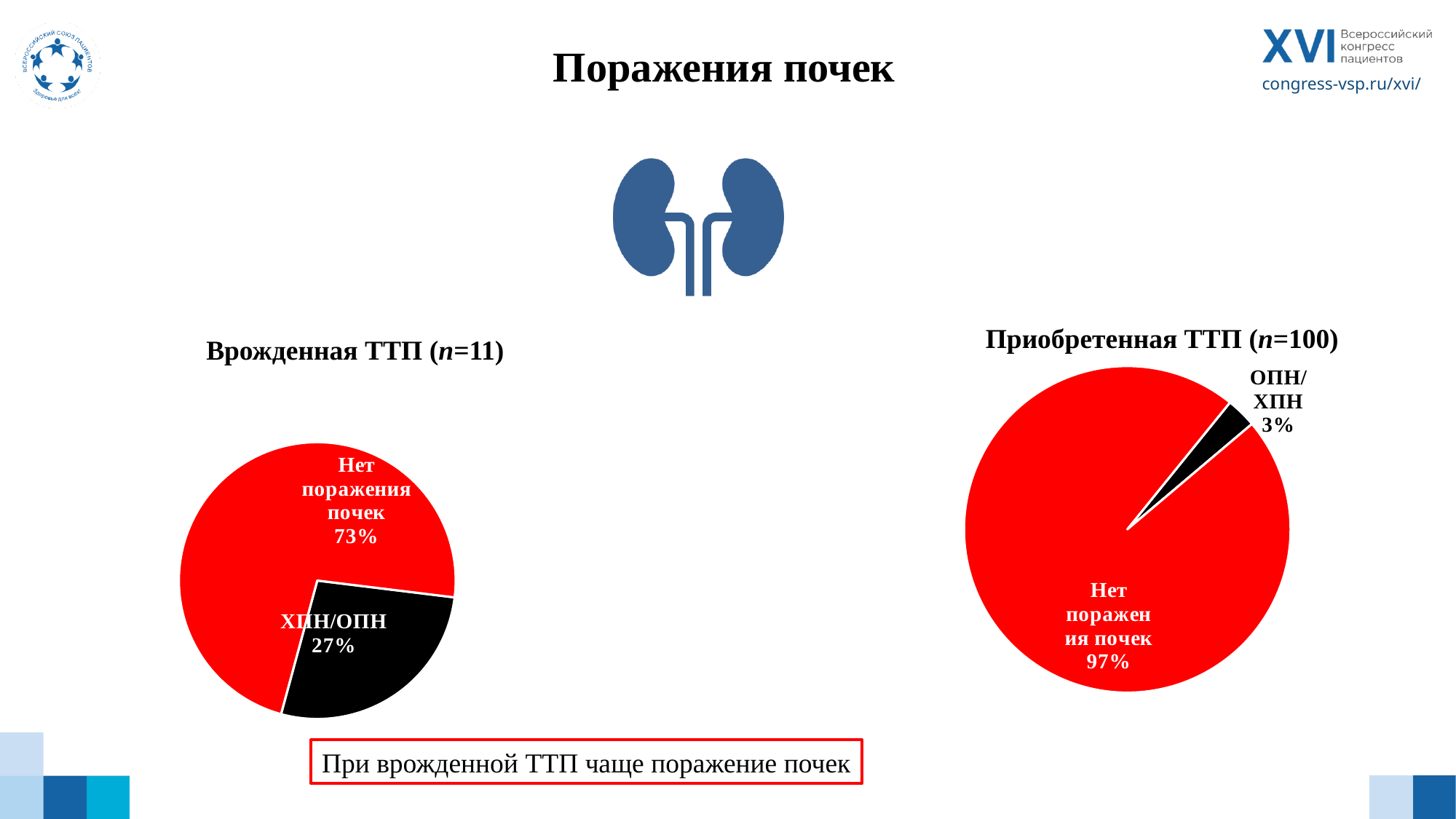
In the 'Приобретенная ТТП (n=100)' pie chart, what share is labelled 'Нет поражения почек'? 97% Which is larger: the 'ХПН/ОПН' share in the 'Врожденная ТТП (n=11)' chart or the 'ОПН/ХПН' share in the 'Приобретенная ТТП (n=100)' chart? ХПН/ОПН in Врожденная ТТП (n=11) What is the title of the slide containing the two pie charts? Поражения почек In the 'Врожденная ТТП (n=11)' pie chart, what is the difference between the 'Нет поражения почек' and 'ХПН/ОПН' shares? 46% In the 'Врожденная ТТП (n=11)' pie chart, what share is labelled 'ХПН/ОПН'? 27% How many slices does the 'Врожденная ТТП (n=11)' pie chart have? 2 In the 'Приобретенная ТТП (n=100)' pie chart, what share is labelled 'ОПН/ХПН'? 3% What type of chart is used for 'Приобретенная ТТП (n=100)'? Pie chart In the 'Врожденная ТТП (n=11)' pie chart, which slice is the largest? Нет поражения почек In the 'Приобретенная ТТП (n=100)' pie chart, which slice is the smallest? ОПН/ХПН In the 'Приобретенная ТТП (n=100)' pie chart, what colour is the 'Нет поражения почек' slice? Red